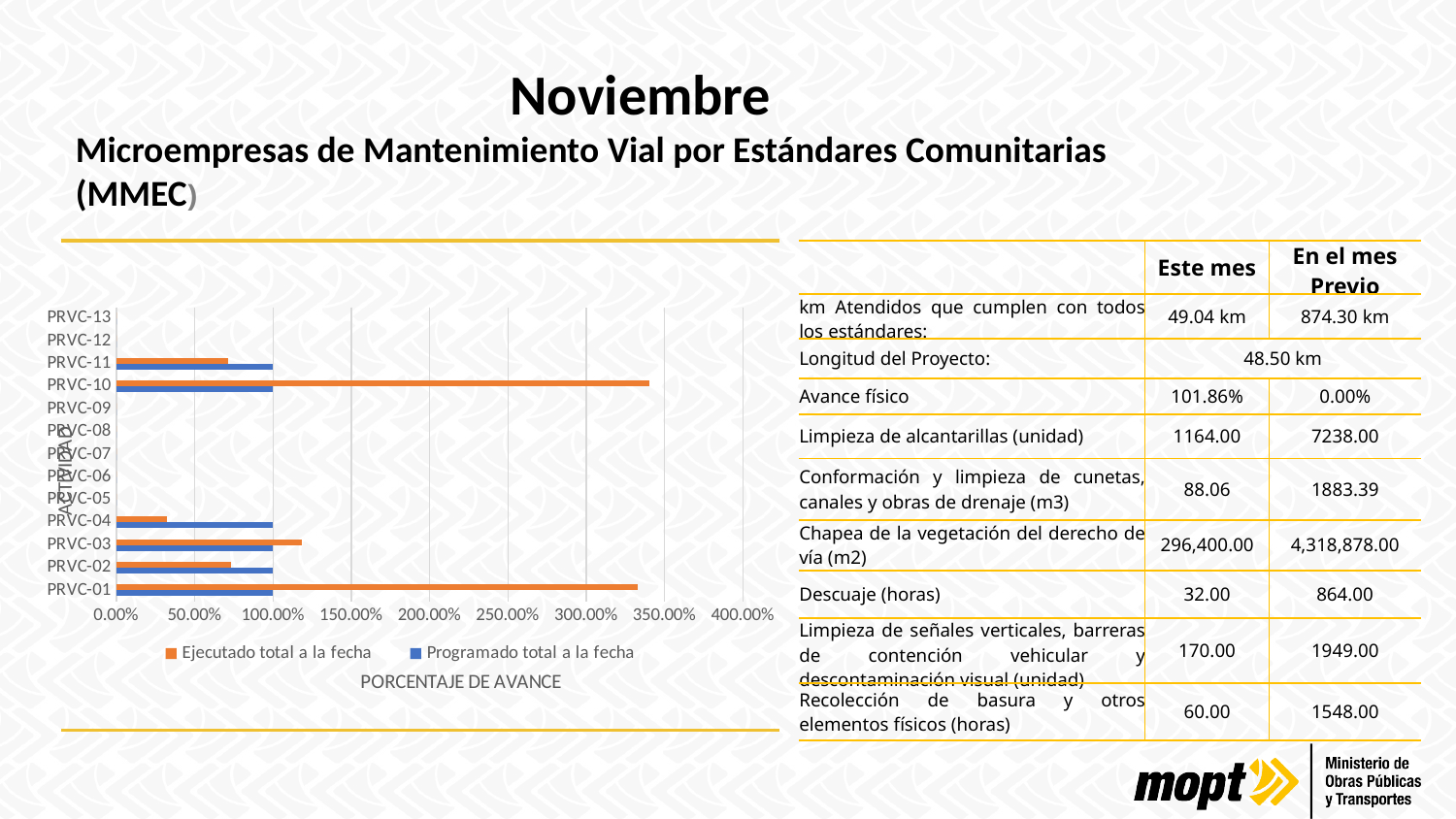
Is the 'Ejecutado total a la fecha' value for PRVC-03 greater or less than 100.00%? greater Is the 'Ejecutado total a la fecha' value for PRVC-01 greater or less than 300.00%? greater What is the title of the chart's horizontal axis? PORCENTAJE DE AVANCE For PRVC-04, which is larger: 'Ejecutado total a la fecha' or 'Programado total a la fecha'? Programado total a la fecha Which has the larger 'Ejecutado total a la fecha' value: PRVC-03 or PRVC-04? PRVC-03 How many PRVC categories are shown on the chart's vertical axis? 13 What is the value of 'Programado total a la fecha' for PRVC-01? 100.00% What kind of chart is shown on the slide? bar chart How many series does the chart legend list? 2 Is the 'Ejecutado total a la fecha' value for PRVC-10 greater or less than 300.00%? greater